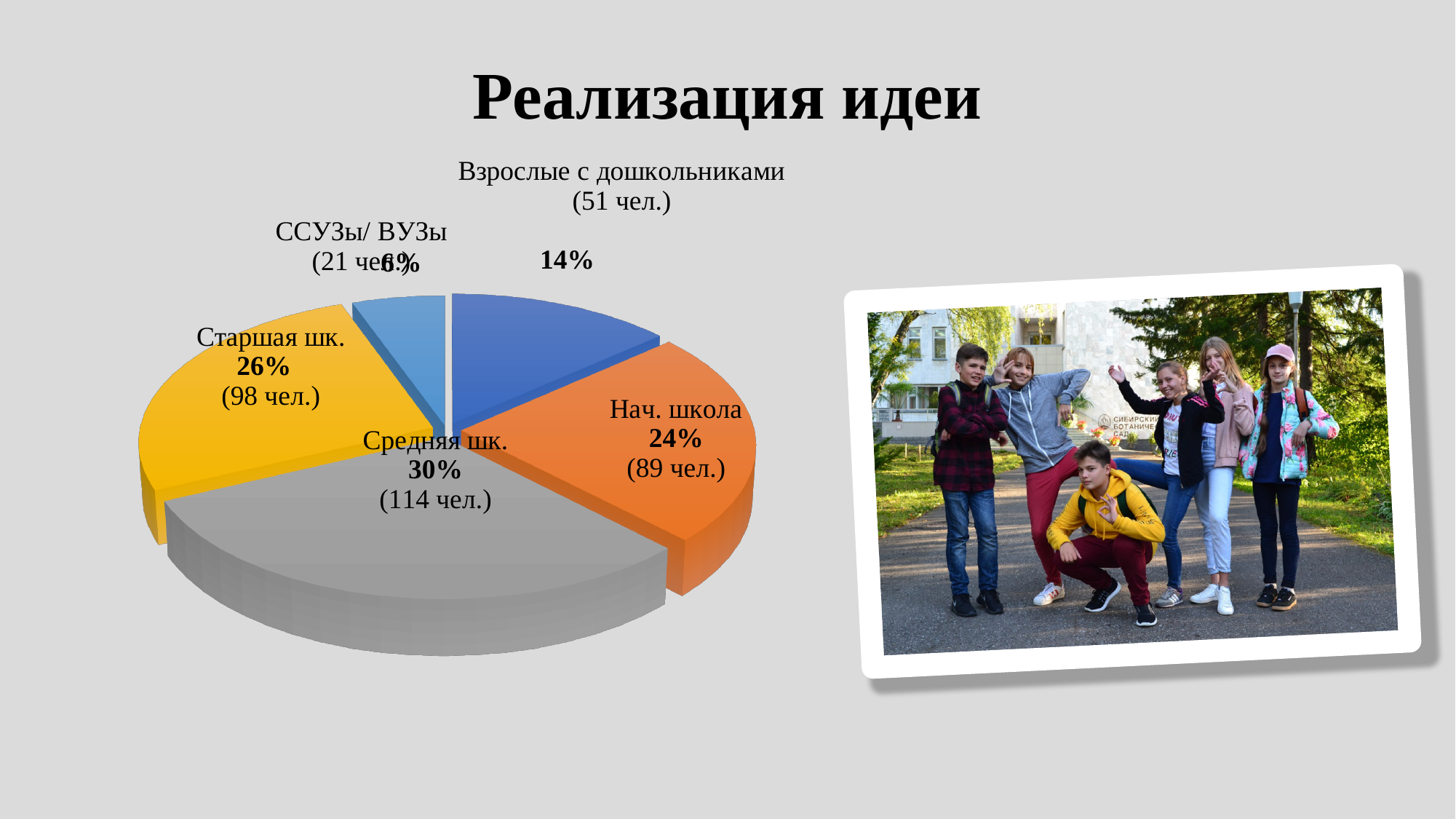
What percentage share does the "Средняя шк." slice have? 30% How many people are in the "Нач. школа" category? 89 чел. Which category has the smallest share of the pie? ССУЗы/ ВУЗы What is the difference in number of people between "Средняя шк." and "Нач. школа"? 25 чел. Which has a larger share: "Старшая шк." or "Нач. школа"? Старшая шк. Which category has the largest share of the pie? Средняя шк. How many slices does the pie chart have? 5 How many people are in the "ССУЗы/ ВУЗы" category? 21 чел. What is the title of the slide containing the pie chart? Реализация идеи What kind of chart is shown on the slide? pie chart What percentage is shown for "Взрослые с дошкольниками"? 14% What is the difference in percentage points between "Средняя шк." and "ССУЗы/ ВУЗы"? 24%